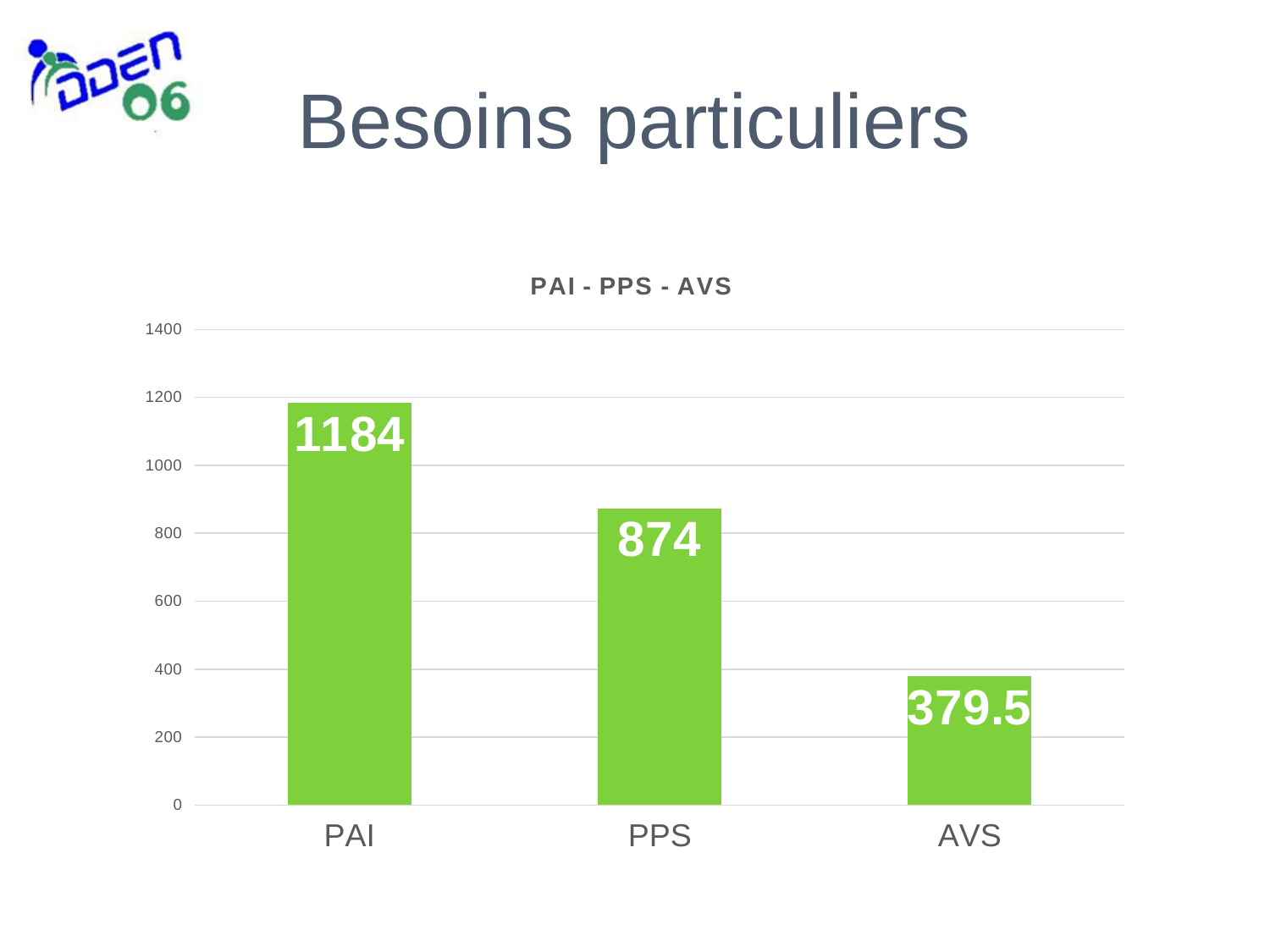
What is the value for PAI? 1184 What is the value for PPS? 874 What is the value for AVS? 379.5 What is the difference between the values for PAI and PPS? 310 Which category has the lowest value? AVS What is the difference between the values for PPS and AVS? 494.5 How many categories are shown on the x axis? 3 What is the title of the chart? PAI - PPS - AVS Which is larger, the value for PPS or the value for AVS? PPS What kind of chart is shown on the slide? bar chart Is the value for AVS greater or less than 400? less Which category has the highest value? PAI